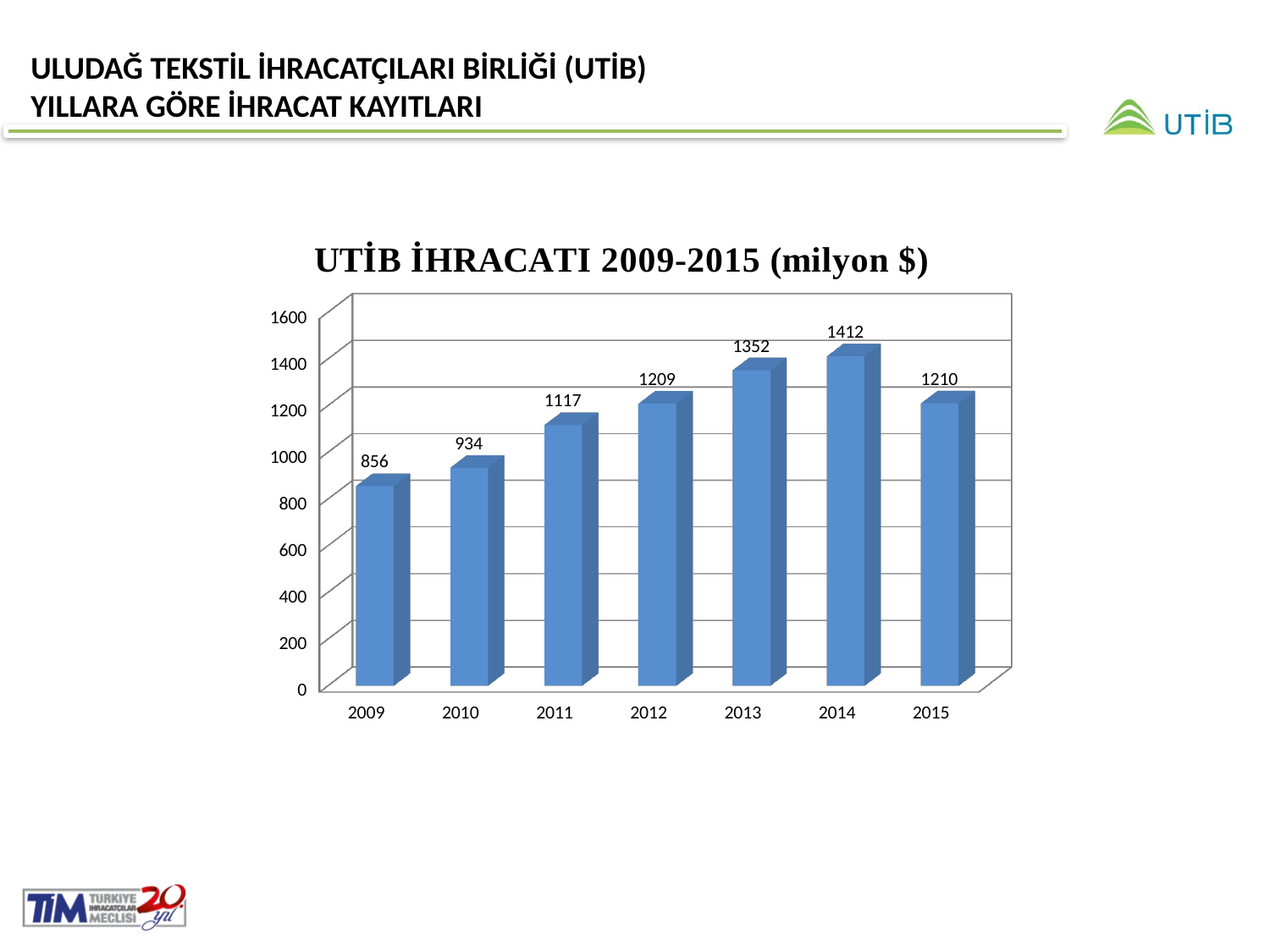
What kind of chart is shown on the slide? bar chart Which year has the lowest value? 2009 What is the value for 2013? 1352 Which year has the highest value? 2014 What is the value for 2015? 1210 How many years are shown on the x axis? 7 What is the difference between the values for 2014 and 2015? 202 What is the difference between the values for 2010 and 2009? 78 Which is larger, the value for 2012 or the value for 2015? 2015 What is the title of the chart? UTİB İHRACATI 2009-2015 (milyon $) What is the value for 2009? 856 Is the value for 2011 greater or less than 1000? greater